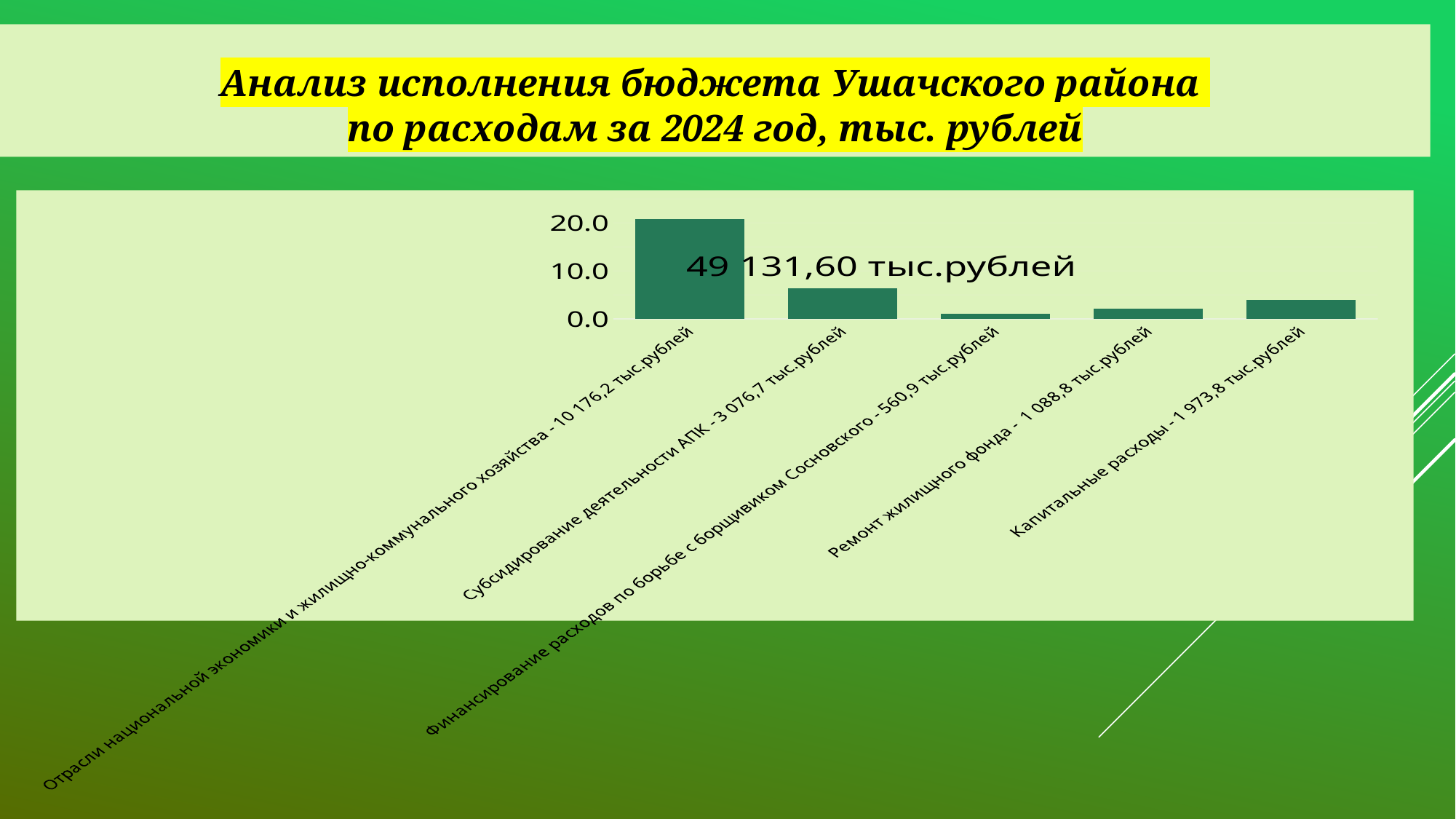
What total amount is printed in large text over the chart area? 49 131,60 тыс.рублей What kind of chart is shown on the slide? bar chart According to the category label, what amount is given for Субсидирование деятельности АПК? 3 076,7 тыс.рублей According to the category label, what amount is given for Ремонт жилищного фонда? 1 088,8 тыс.рублей How many categories (bars) does the chart show? 5 Is the bar for Капитальные расходы greater or less than 10.0? less Is the bar for Субсидирование деятельности АПК greater or less than 10.0? less Which category has the highest bar? Отрасли национальной экономики и жилищно-коммунального хозяйства What is the difference between the amounts given in the labels for Отрасли национальной экономики и жилищно-коммунального хозяйства (10 176,2) and Субсидирование деятельности АПК (3 076,7)? 7 099,5 тыс.рублей Is the bar for Отрасли национальной экономики и жилищно-коммунального хозяйства greater or less than 10.0? greater Which category has the lowest bar? Финансирование расходов по борьбе с борщивиком Сосновского Which bar is taller: Капитальные расходы or Ремонт жилищного фонда? Капитальные расходы